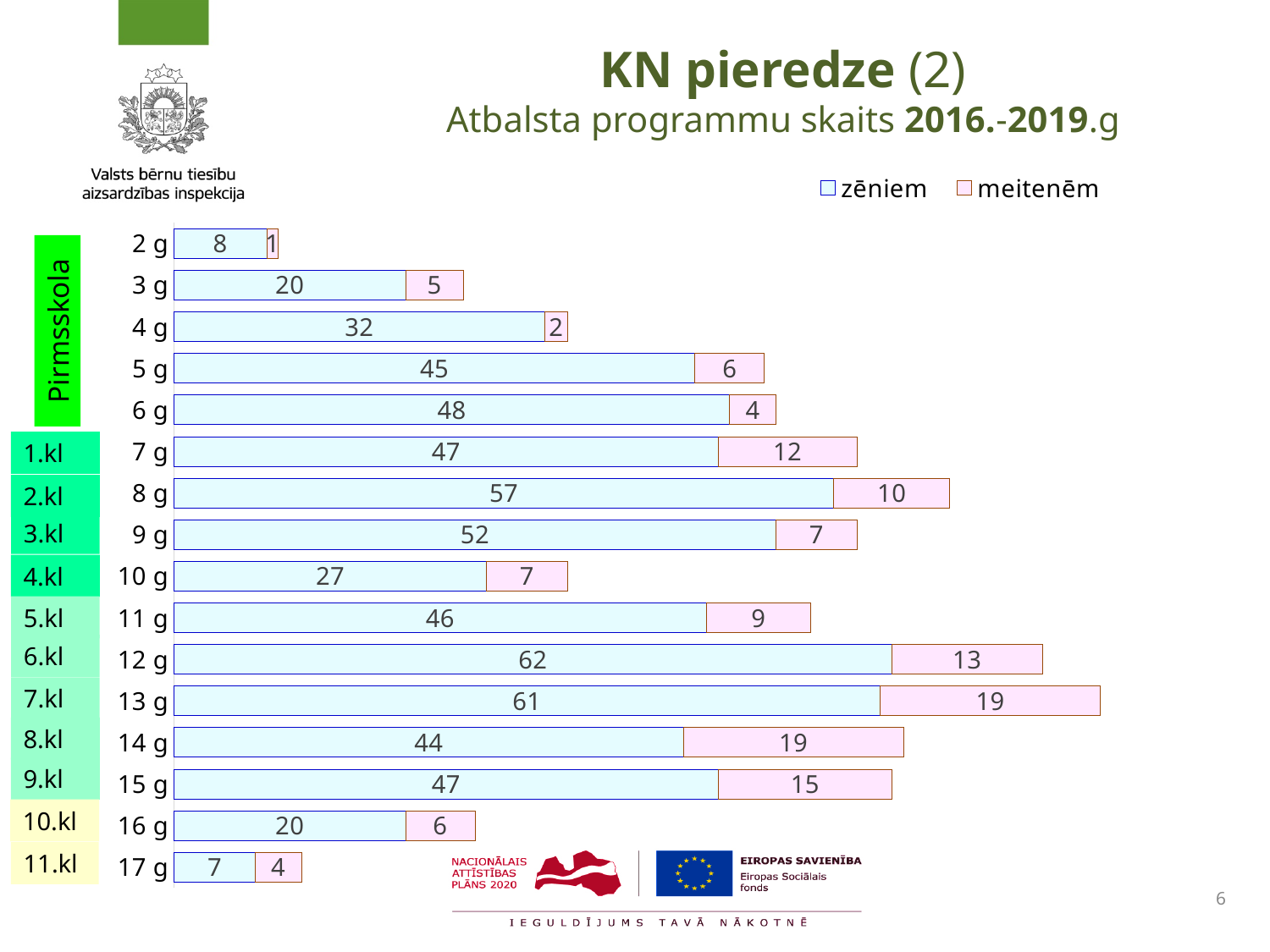
What are the two series named in the legend? zēniem and meitenēm Which age category has the lowest value for zēniem? 17 g What is the value for zēniem at 8 g? 57 How many series does the legend list? 2 Which age category has the highest value for zēniem? 12 g How many age categories are plotted in the chart? 16 Which is larger: the zēniem value for 6 g or for 11 g? 6 g What is the difference between the zēniem values for 12 g and 10 g? 35 What is the total of the stacked bar for 13 g? 80 What kind of chart is shown on the slide? stacked bar chart What is the value for meitenēm at 13 g? 19 Which age category has the lowest value for meitenēm? 2 g